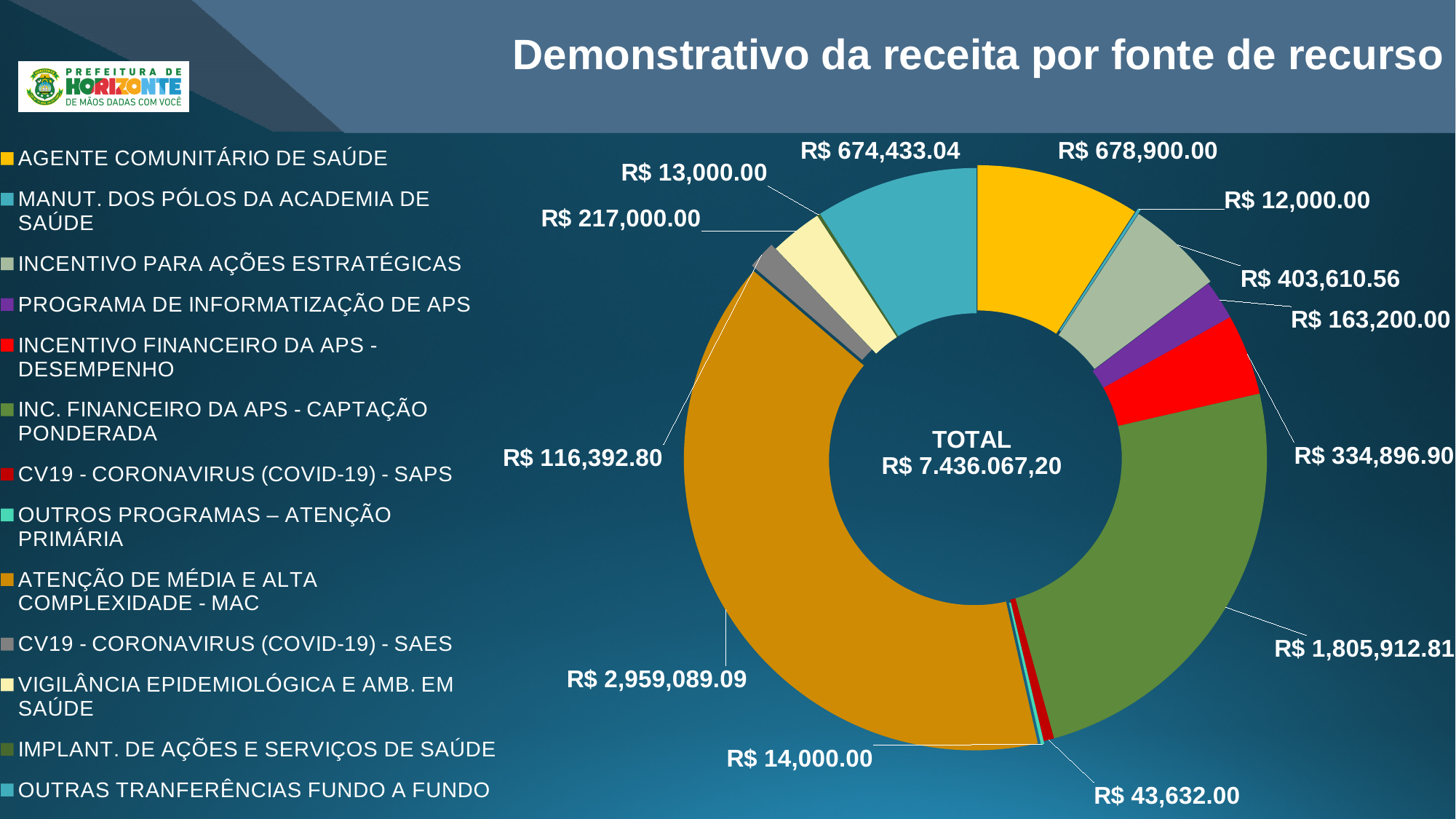
What total is shown in the centre of the chart? R$ 7.436.067,20 What is the value for ATENÇÃO DE MÉDIA E ALTA COMPLEXIDADE - MAC? R$ 2,959,089.09 What kind of chart is shown on the slide? Pie (doughnut) chart What is the value for INC. FINANCEIRO DA APS - CAPTAÇÃO PONDERADA? R$ 1,805,912.81 Which is larger: INCENTIVO PARA AÇÕES ESTRATÉGICAS or INCENTIVO FINANCEIRO DA APS - DESEMPENHO? INCENTIVO PARA AÇÕES ESTRATÉGICAS What is the value for CV19 - CORONAVIRUS (COVID-19) - SAPS? R$ 43,632.00 Which category has the smallest value? MANUT. DOS PÓLOS DA ACADEMIA DE SAÚDE Which category has the largest value? ATENÇÃO DE MÉDIA E ALTA COMPLEXIDADE - MAC What is the difference between the values for ATENÇÃO DE MÉDIA E ALTA COMPLEXIDADE - MAC and INC. FINANCEIRO DA APS - CAPTAÇÃO PONDERADA? R$ 1,153,176.28 How many categories does the chart show? 13 What is the title of the slide? Demonstrativo da receita por fonte de recurso What is the value for VIGILÂNCIA EPIDEMIOLÓGICA E AMB. EM SAÚDE? R$ 217,000.00